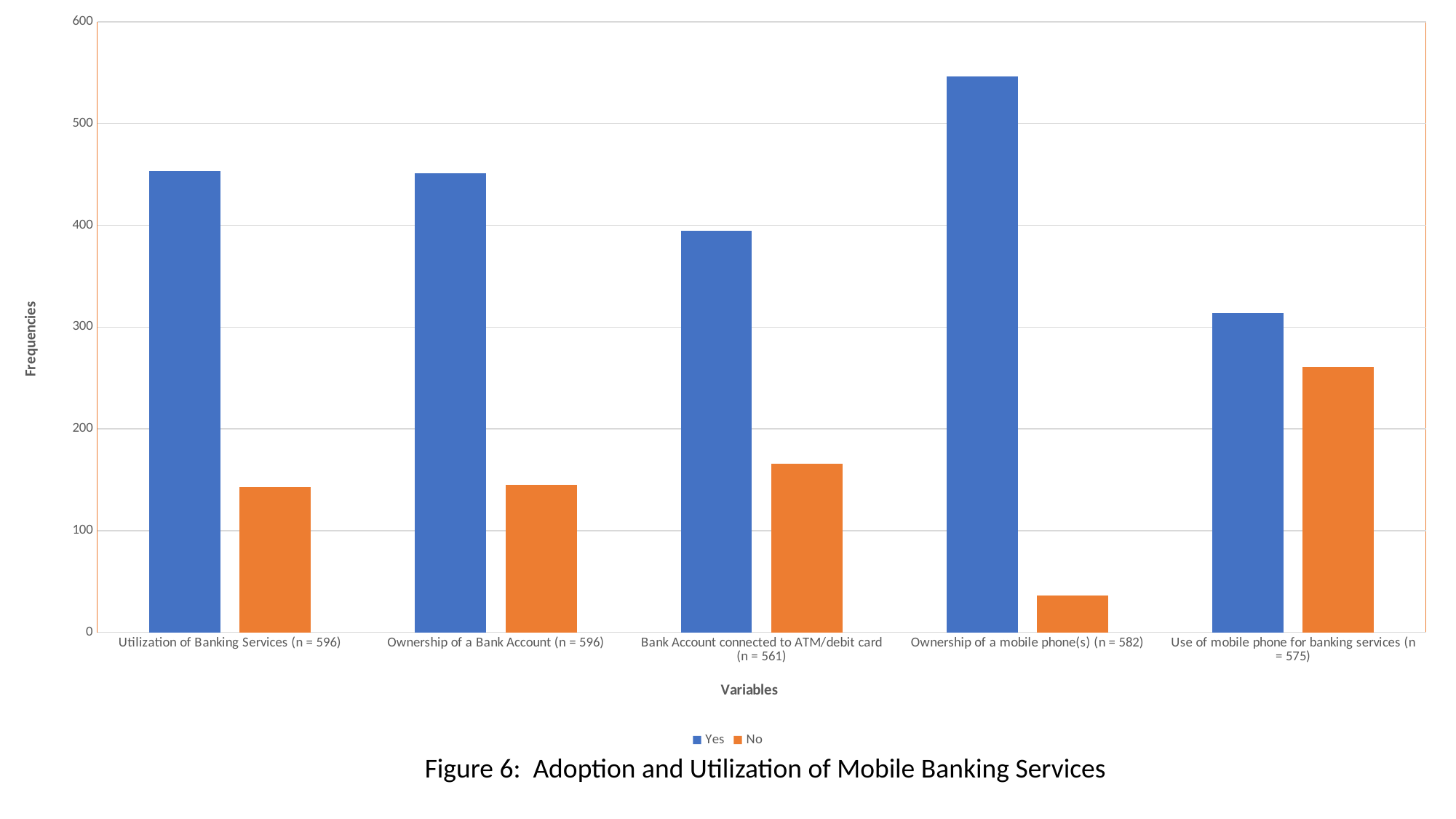
Is the No value for Ownership of a mobile phone(s) greater or less than 100? less Which category has the highest Yes value? Ownership of a mobile phone(s) (n = 582) Is the No value for Use of mobile phone for banking services greater or less than 200? greater Which category has the lowest No value? Ownership of a mobile phone(s) (n = 582) How many series does the legend list? 2 What kind of chart is shown on the slide? bar chart Which category has the lowest Yes value? Use of mobile phone for banking services (n = 575) What is the title of the figure shown on the slide? Figure 6: Adoption and Utilization of Mobile Banking Services Is the Yes value for Ownership of a mobile phone(s) greater or less than 500? greater Which category has the highest No value? Use of mobile phone for banking services (n = 575) Which is larger for Bank Account connected to ATM/debit card: the Yes value or the No value? Yes How many categories are shown on the x axis? 5